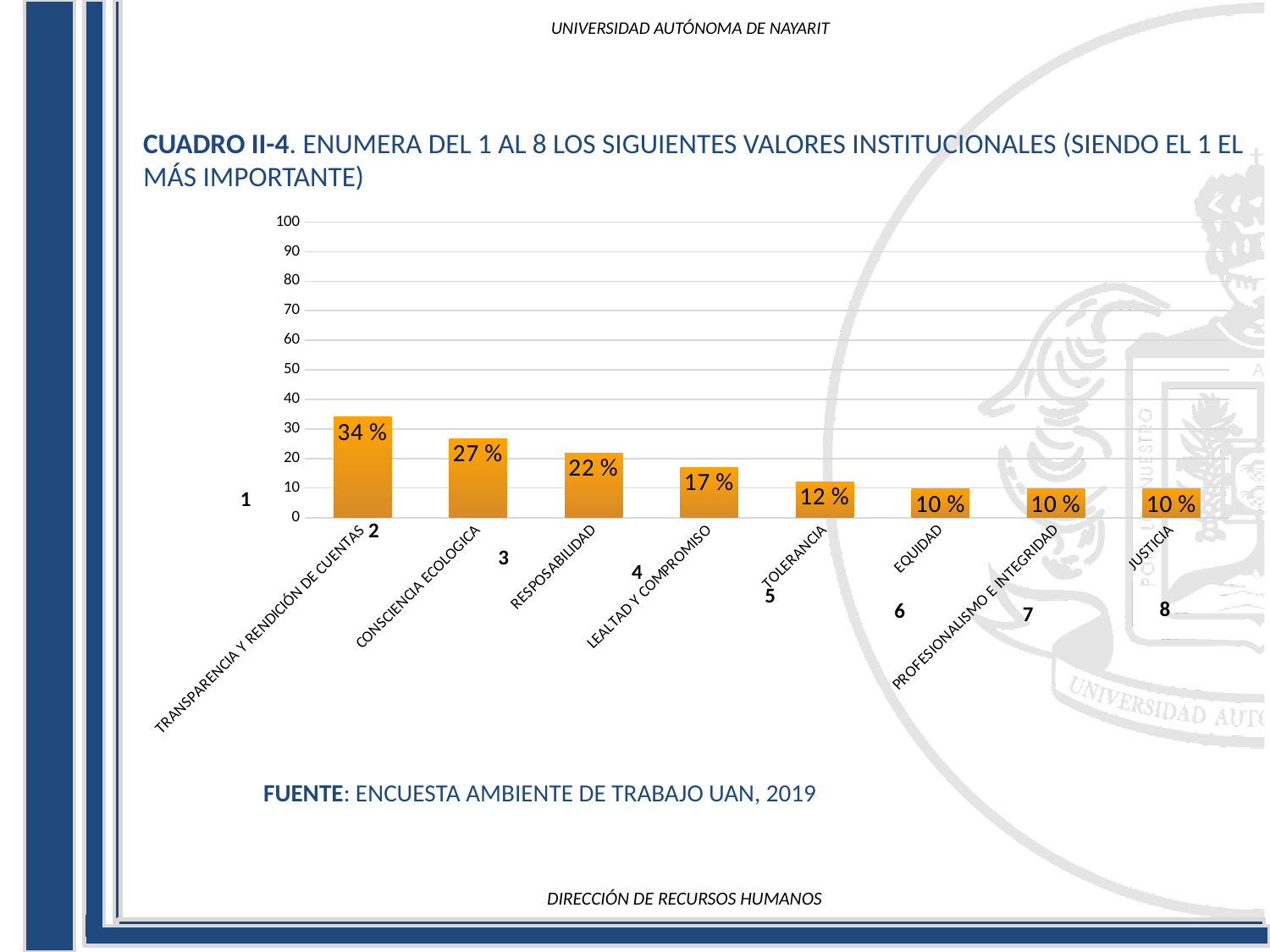
What is the difference between the values for TRANSPARENCIA Y RENDICIÓN DE CUENTAS and CONSCIENCIA ECOLOGICA? 7 % What is the difference between the values for RESPOSABILIDAD and TOLERANCIA? 10 % What value is shown for LEALTAD Y COMPROMISO? 17 % Is the value for TOLERANCIA greater or less than 20? less What value is shown for TOLERANCIA? 12 % What value is shown for CONSCIENCIA ECOLOGICA? 27 % What value is shown for TRANSPARENCIA Y RENDICIÓN DE CUENTAS? 34 % How many categories are shown in the chart? 8 Which is larger, the value for CONSCIENCIA ECOLOGICA or the value for RESPOSABILIDAD? CONSCIENCIA ECOLOGICA Do the values rise or fall from left to right across the categories? fall Which category has the highest value? TRANSPARENCIA Y RENDICIÓN DE CUENTAS What kind of chart is shown on the slide? bar chart